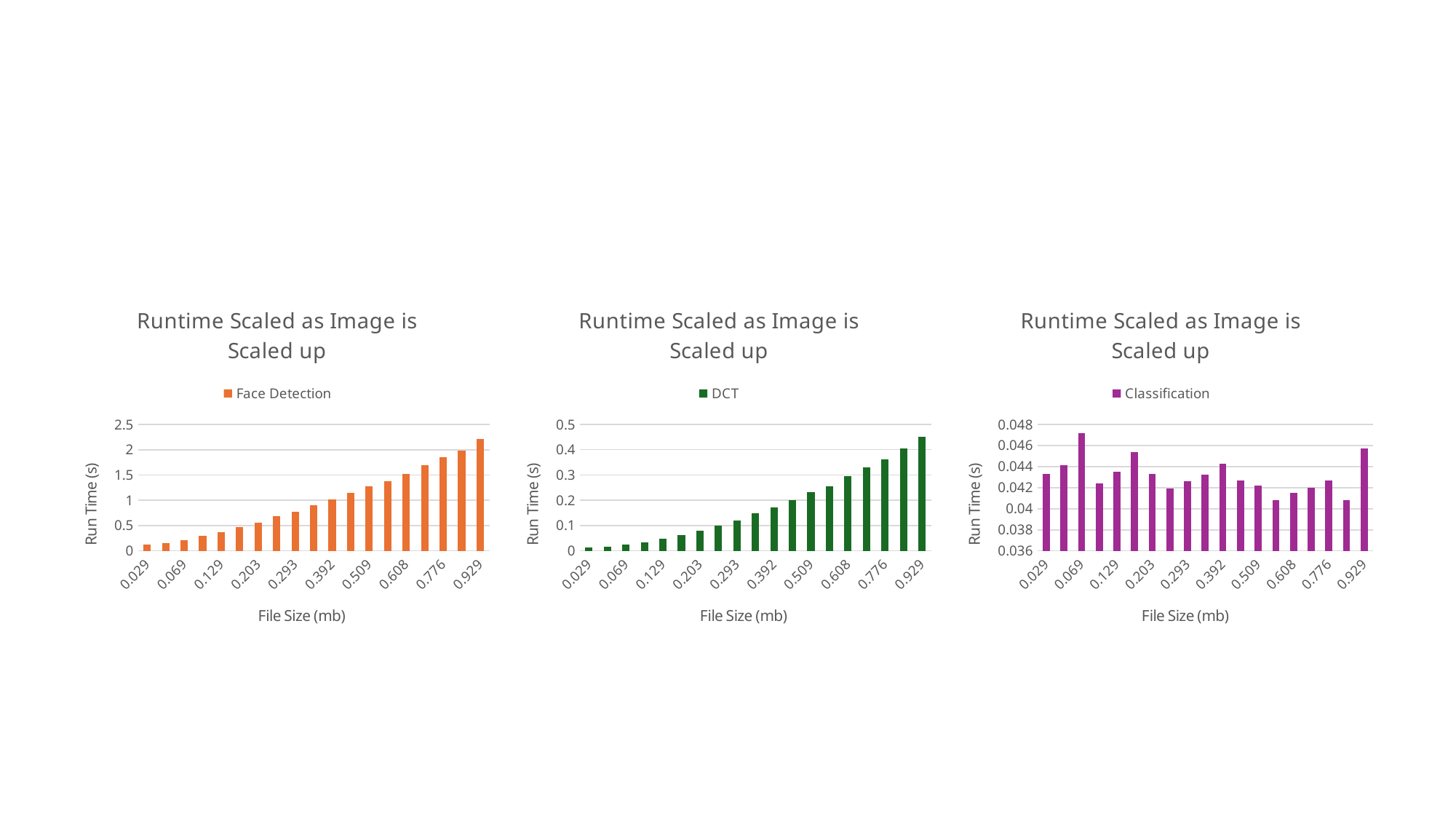
In the left chart (Face Detection), is the run time for file size 0.029 greater or less than 0.5? less In the right chart (Classification), which has the larger run time: file size 0.069 or file size 0.608? 0.069 In the left chart (Face Detection), which file size has the highest run time? 0.929 In the right chart (Classification), is the run time for file size 0.069 greater or less than 0.046? greater In the left chart (Face Detection), is the run time for file size 0.929 greater or less than 2? greater What series does the legend of the middle chart list? DCT In the middle chart (DCT), which file size has the highest run time? 0.929 In the right chart (Classification), which file size has the highest run time? 0.069 What kind of chart is the left chart (Face Detection)? bar chart In the left chart (Face Detection), do run times rise or fall as file size increases along the x axis? rise